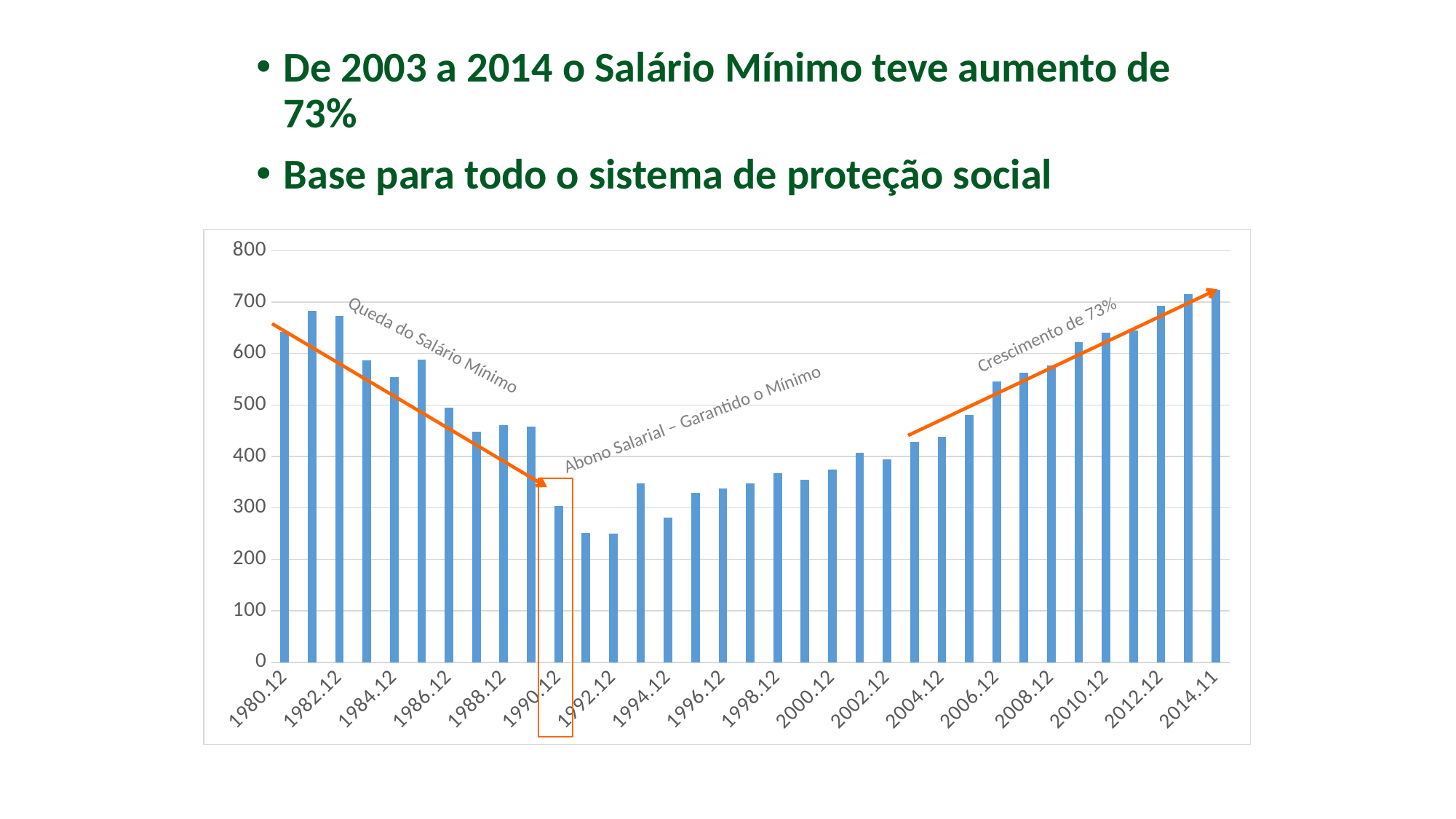
Is the value for 2014.11 greater or less than 700? greater What text is written along the rising orange arrow on the right side of the chart? Crescimento de 73% Is the value for 2008.12 greater or less than 500? greater Which has the larger value, 1990.12 or 1992.12? 1990.12 Is the value for 2002.12 greater or less than 500? less What kind of chart is shown on the slide? bar chart Do the values rise or fall from 2002.12 to 2014.11? rise Do the values rise or fall from 1980.12 to 1992.12? fall Which has the larger value, 1980.12 or 2014.11? 2014.11